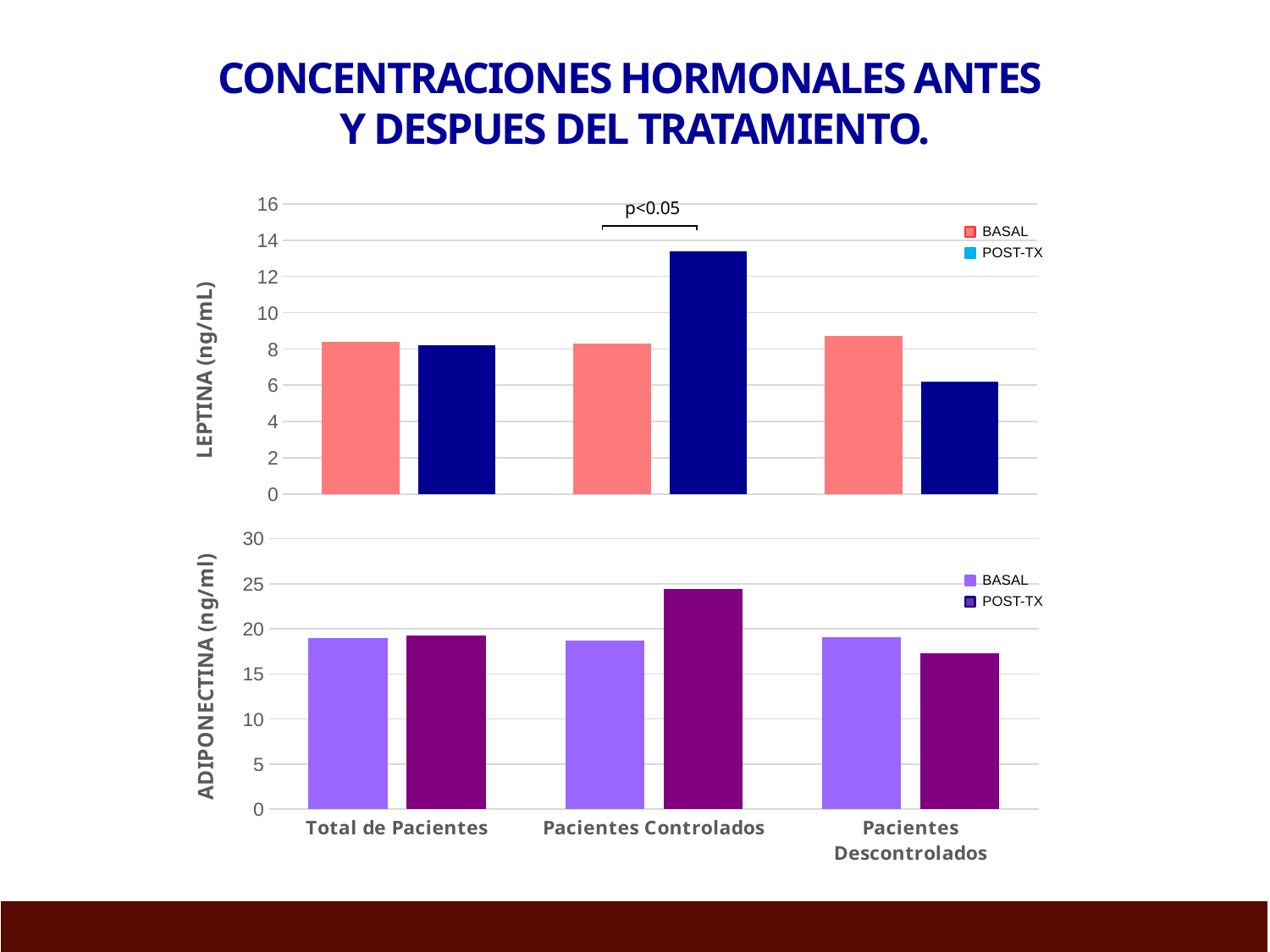
In the top chart (LEPTINA), which bar is the highest? POST-TX for Pacientes Controlados In the top chart (LEPTINA), what p-value annotation is shown above the Pacientes Controlados bars? p<0.05 In the top chart (LEPTINA), is the POST-TX value for Pacientes Descontrolados greater or less than 8? less What kind of chart is the top chart (LEPTINA)? bar chart In the bottom chart (ADIPONECTINA), how many patient groups are shown on the x axis? 3 In the top chart (LEPTINA), is the POST-TX value for Pacientes Controlados greater or less than 12? greater In the bottom chart (ADIPONECTINA), for Pacientes Descontrolados, which is larger: BASAL or POST-TX? BASAL In the bottom chart (ADIPONECTINA), which bar is the highest? POST-TX for Pacientes Controlados In the top chart (LEPTINA), for Pacientes Descontrolados, which is larger: BASAL or POST-TX? BASAL In the top chart (LEPTINA), how many series does the legend list? 2 In the bottom chart (ADIPONECTINA), is the POST-TX value for Pacientes Controlados greater or less than 20? greater In the top chart (LEPTINA), which bar is the lowest? POST-TX for Pacientes Descontrolados